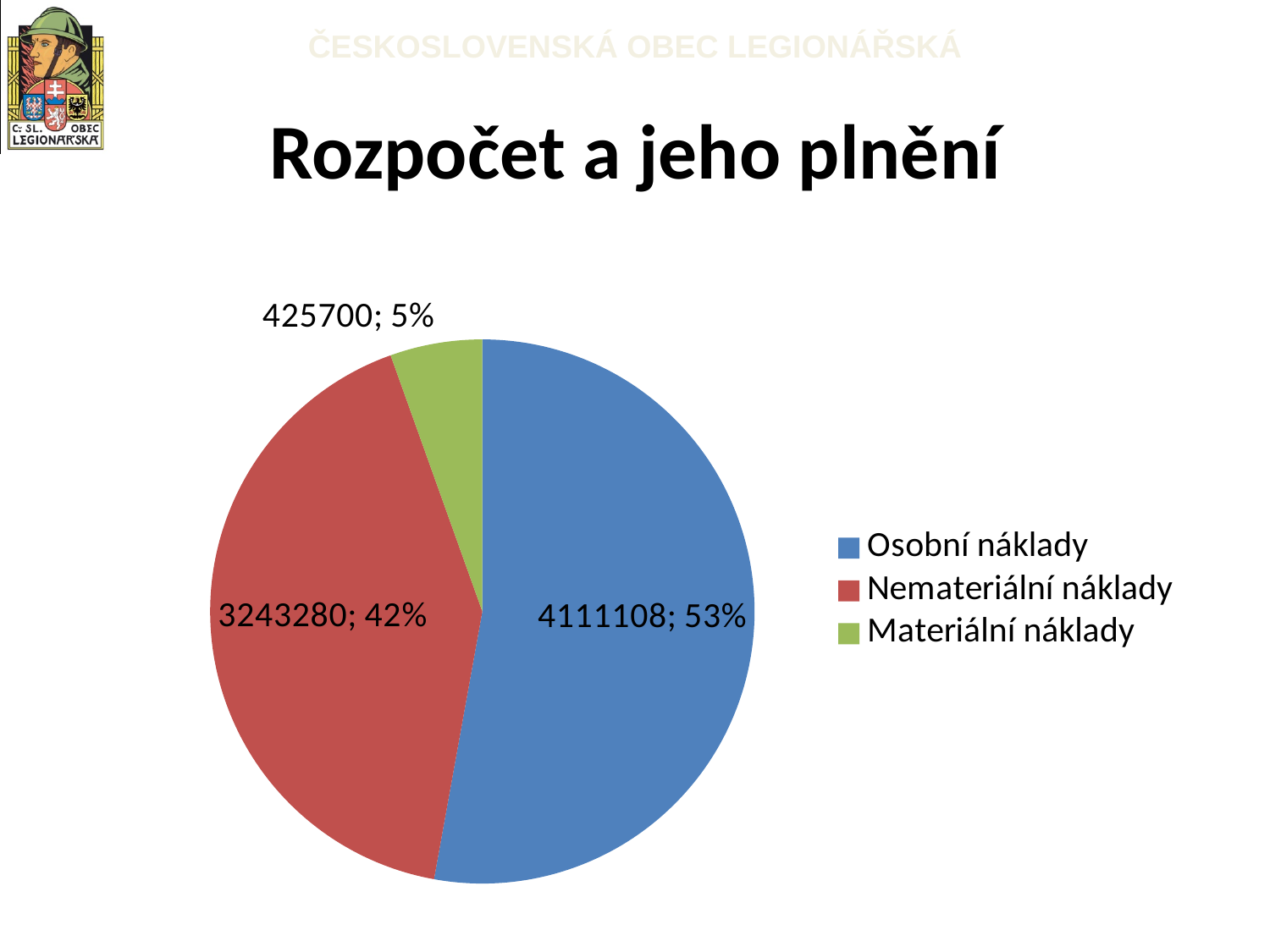
How many categories does the pie chart have? 3 Which is larger, Nemateriální náklady or Materiální náklady? Nemateriální náklady Which category has the largest slice? Osobní náklady What colour is the slice for Nemateriální náklady? red What kind of chart is shown on the slide? pie chart What is the difference between the values for Osobní náklady and Nemateriální náklady? 867828 What is the value for Nemateriální náklady? 3243280 What is the value for Osobní náklady? 4111108 Which category has the smallest slice? Materiální náklady What share of the pie does Osobní náklady represent? 53% What share of the pie does Materiální náklady represent? 5% What is the value for Materiální náklady? 425700